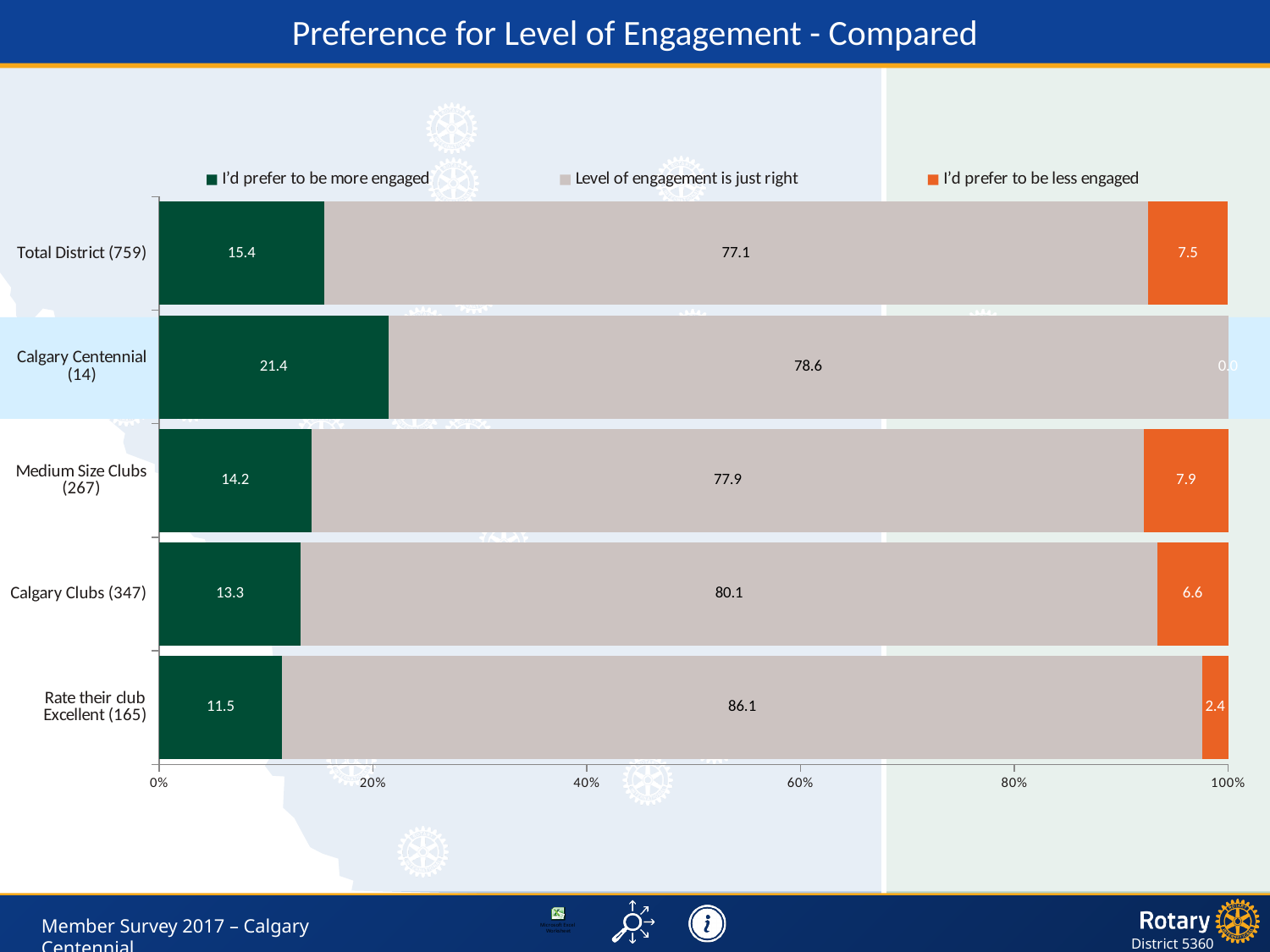
What is the value for "Level of engagement is just right" for Calgary Centennial (14)? 78.6 What is the value for "I'd prefer to be more engaged" for Total District (759)? 15.4 What is the value for "I'd prefer to be less engaged" for Medium Size Clubs (267)? 7.9 Which category has the highest value for "I'd prefer to be more engaged"? Calgary Centennial (14) How many series does the legend list? 3 How many categories are plotted on the chart? 5 Which is larger: the "I'd prefer to be less engaged" value for Calgary Clubs (347) or for Rate their club Excellent (165)? Calgary Clubs (347) What is the title of the chart? Preference for Level of Engagement - Compared What is the difference between the "Level of engagement is just right" values for Calgary Clubs (347) and Total District (759)? 3.0 Which category has the lowest value for "Level of engagement is just right"? Total District (759) What type of chart is shown on the slide? Stacked bar chart What is the value for "Level of engagement is just right" for Rate their club Excellent (165)? 86.1